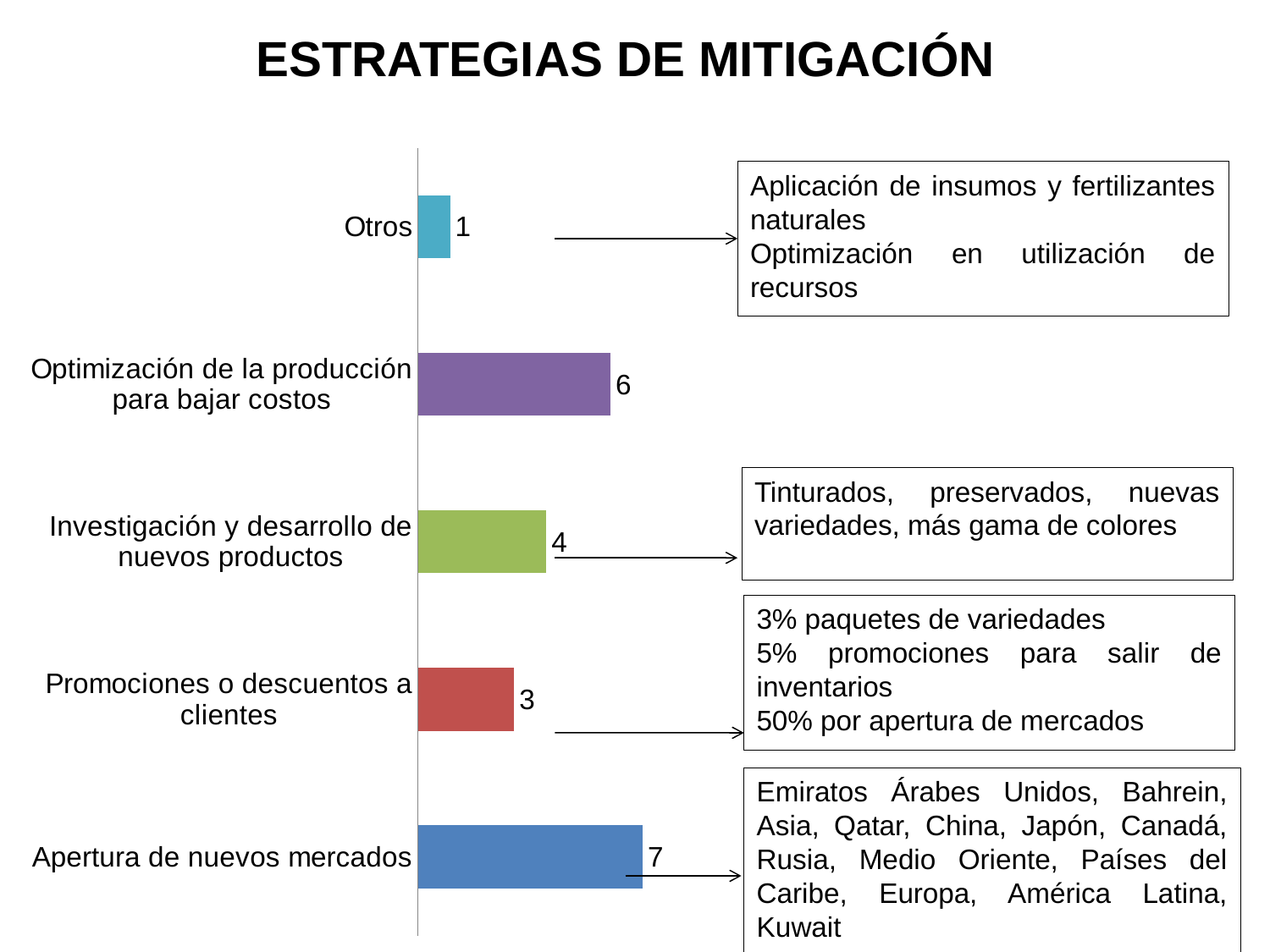
What is the value for "Promociones o descuentos a clientes"? 3 What is the value for "Investigación y desarrollo de nuevos productos"? 4 What kind of chart is shown on the slide? Bar chart Which category has the lowest value? Otros What is the value for "Apertura de nuevos mercados"? 7 What is the title of the slide? ESTRATEGIAS DE MITIGACIÓN Which is larger, the value for "Optimización de la producción para bajar costos" or the value for "Investigación y desarrollo de nuevos productos"? Optimización de la producción para bajar costos What is the value for "Otros"? 1 Which category has the highest value? Apertura de nuevos mercados What is the difference between the values for "Apertura de nuevos mercados" and "Promociones o descuentos a clientes"? 4 What is the value for "Optimización de la producción para bajar costos"? 6 How many categories are shown in the chart? 5